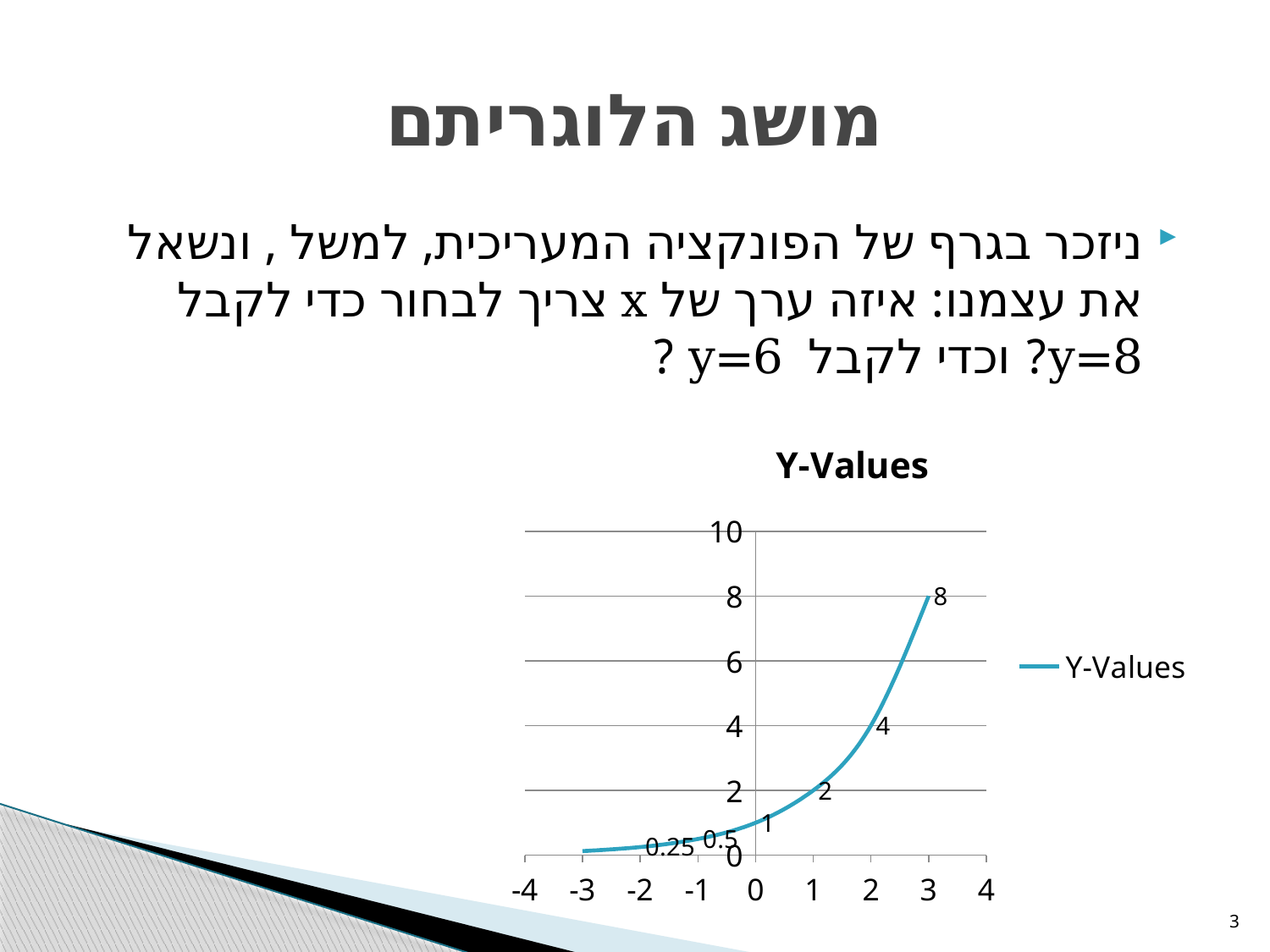
What is the y-value plotted at x = 3? 8 What is the y-value plotted at x = -1? 0.5 What kind of chart is shown on the slide? line chart What is the highest labeled y-value on the chart? 8 What is the y-value plotted at x = 0? 1 Which has a larger y-value, x = 2 or x = 1? x = 2 Do the y-values rise or fall as x increases along the x axis? rise What is the y-value plotted at x = 2? 4 What is the y-value plotted at x = -2? 0.25 What is the y-value plotted at x = 1? 2 How many series does the legend list? 1 What is the difference between the y-values at x = 3 and x = 2? 4